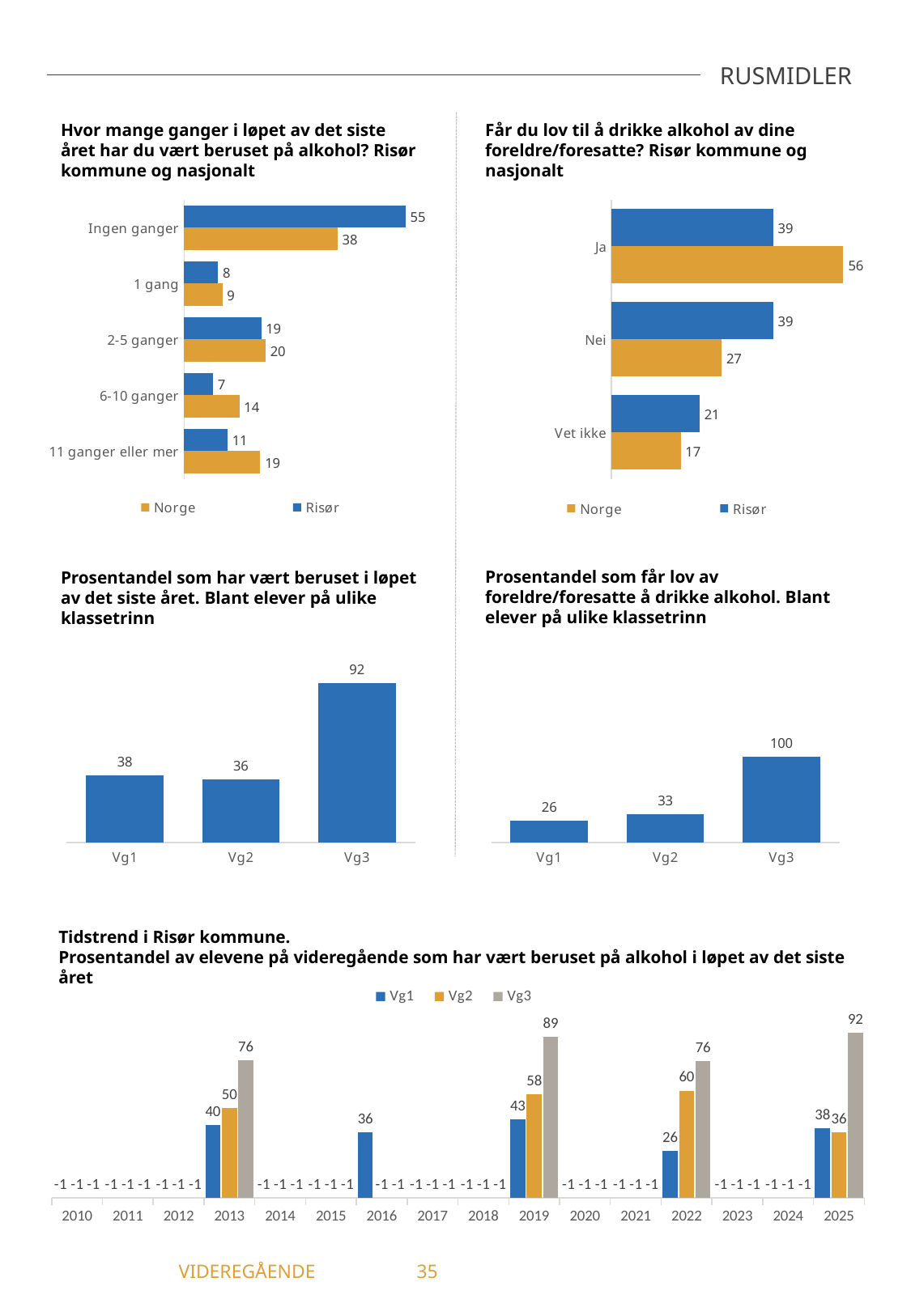
In the chart 'Prosentandel som har vært beruset i løpet av det siste året', what is the value for Vg2? 36 In the chart 'Prosentandel som får lov av foreldre/foresatte å drikke alkohol', which class level has the lowest value? Vg1 In the chart 'Får du lov til å drikke alkohol av dine foreldre/foresatte?', how many series does the legend list? 2 In the chart 'Prosentandel som får lov av foreldre/foresatte å drikke alkohol', what kind of chart is it? Bar chart In the chart 'Hvor mange ganger i løpet av det siste året har du vært beruset på alkohol?', what is the difference between Norge and Risør for '6-10 ganger'? 7 In the chart 'Tidstrend i Risør kommune', what is the value for Vg2 in 2022? 60 In the chart 'Får du lov til å drikke alkohol av dine foreldre/foresatte?', what is the value for Norge for 'Ja'? 56 In the chart 'Får du lov til å drikke alkohol av dine foreldre/foresatte?', which is larger for 'Nei': Risør or Norge? Risør In the chart 'Hvor mange ganger i løpet av det siste året har du vært beruset på alkohol?', what is the value for Risør in the category 'Ingen ganger'? 55 In the chart 'Tidstrend i Risør kommune', what is the difference between Vg3 and Vg1 in 2025? 54 In the chart 'Prosentandel som har vært beruset i løpet av det siste året', which class level has the highest value? Vg3 In the chart 'Hvor mange ganger i løpet av det siste året har du vært beruset på alkohol?', how many categories are shown? 5